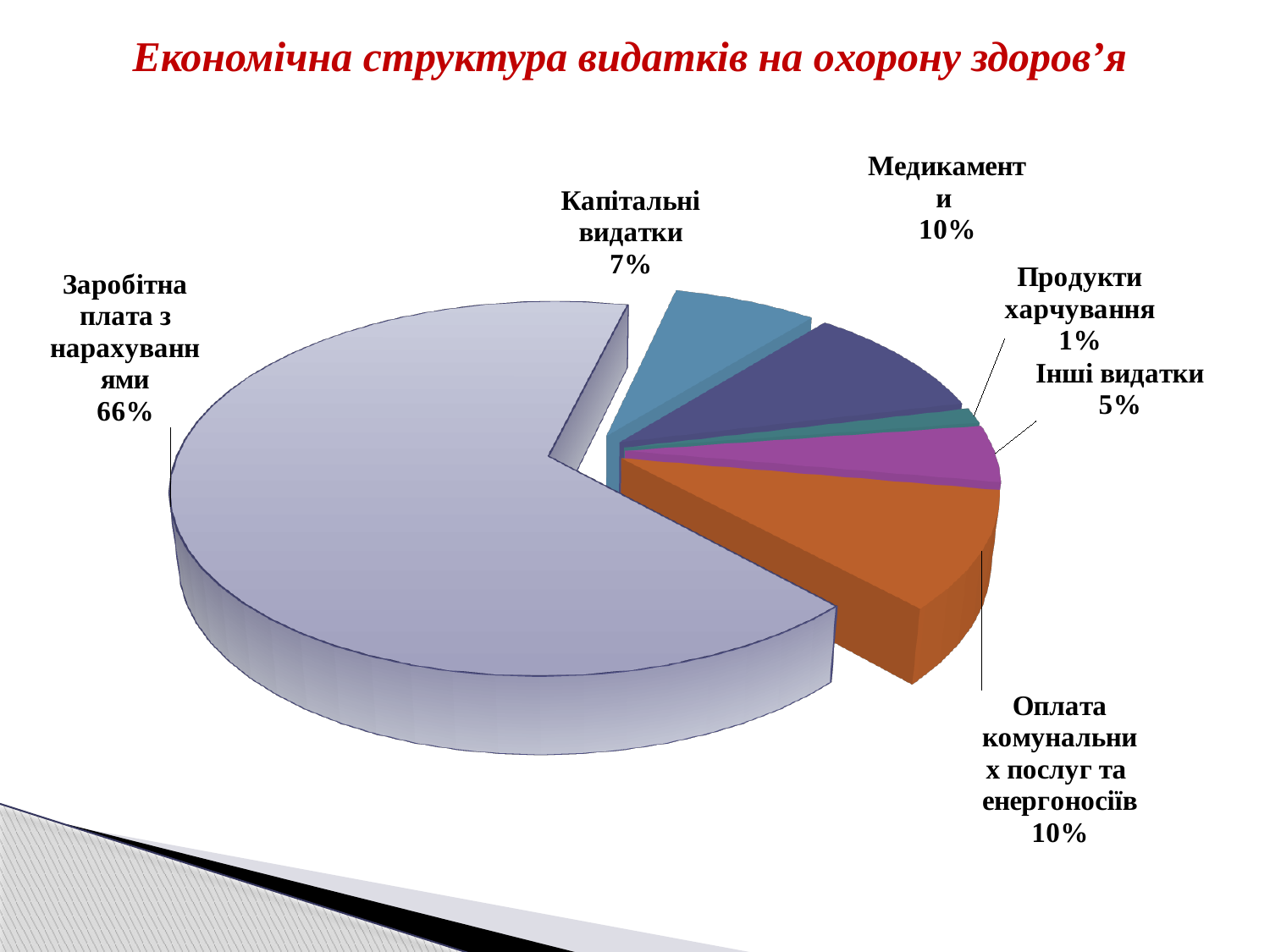
What share of the pie is labelled "Медикаменти"? 10% What is the difference between the shares for "Капітальні видатки" and "Інші видатки"? 2% What share of the pie is labelled "Інші видатки"? 5% What share of the pie is labelled "Заробітна плата з нарахуваннями"? 66% What is the title of the chart? Економічна структура видатків на охорону здоров'я What kind of chart is shown on the slide? Pie chart How many slices does the pie chart have? 6 Which slice of the pie is the largest? Заробітна плата з нарахуваннями Which slice of the pie is the smallest? Продукти харчування